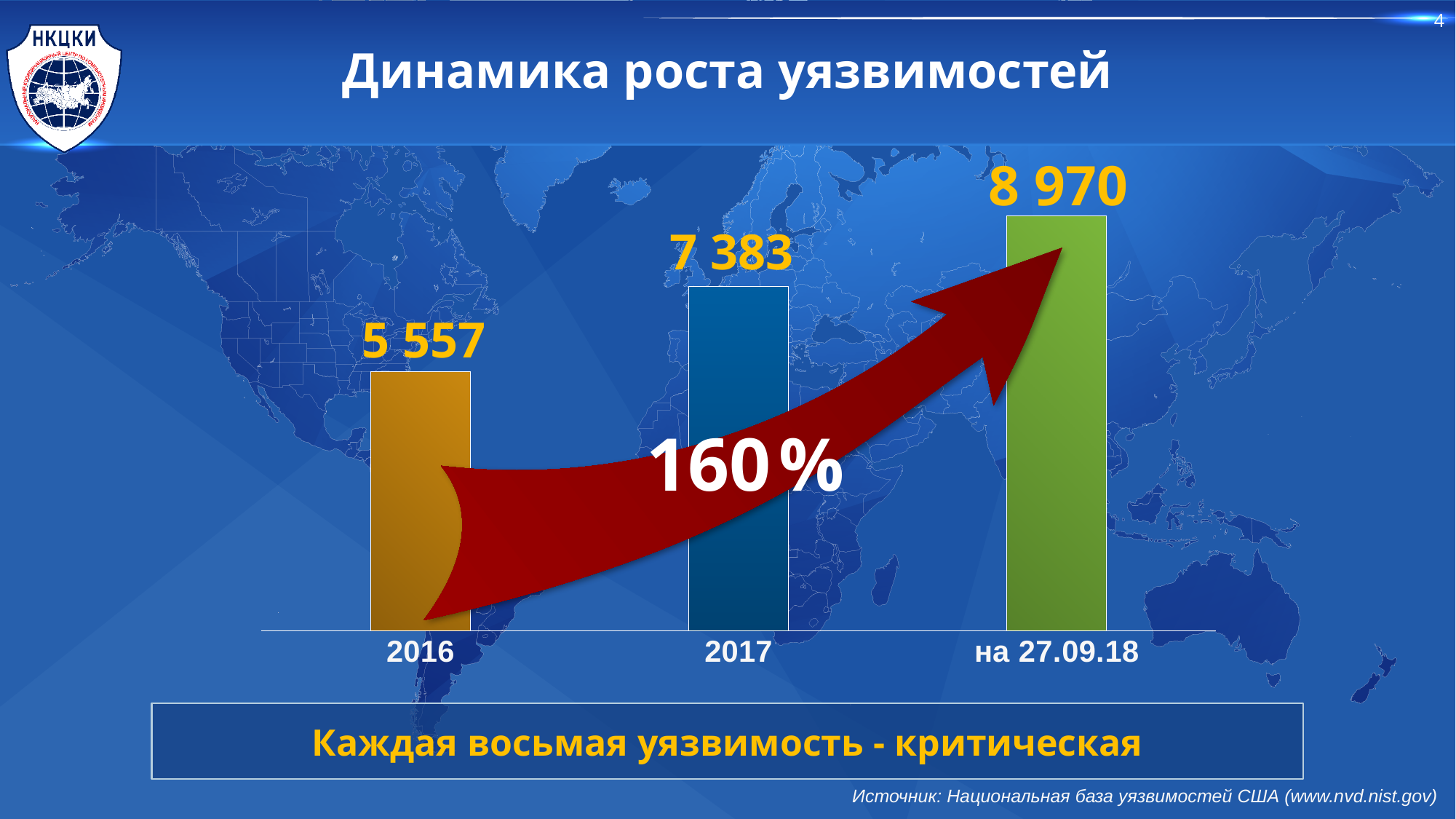
What is the difference between the values for на 27.09.18 and 2017? 1 587 What is the value shown for на 27.09.18? 8 970 Which category has the highest value? на 27.09.18 Which category has the lowest value? 2016 What is the difference between the values for 2017 and 2016? 1 826 Which is larger, the value for 2016 or the value for 2017? 2017 How many bars are shown in the chart? 3 What is the value shown for 2017? 7 383 What kind of chart is shown on the slide? bar chart What percentage is printed on the red arrow over the chart? 160% What is the value shown for 2016? 5 557 Do the values rise or fall from 2016 to на 27.09.18? rise